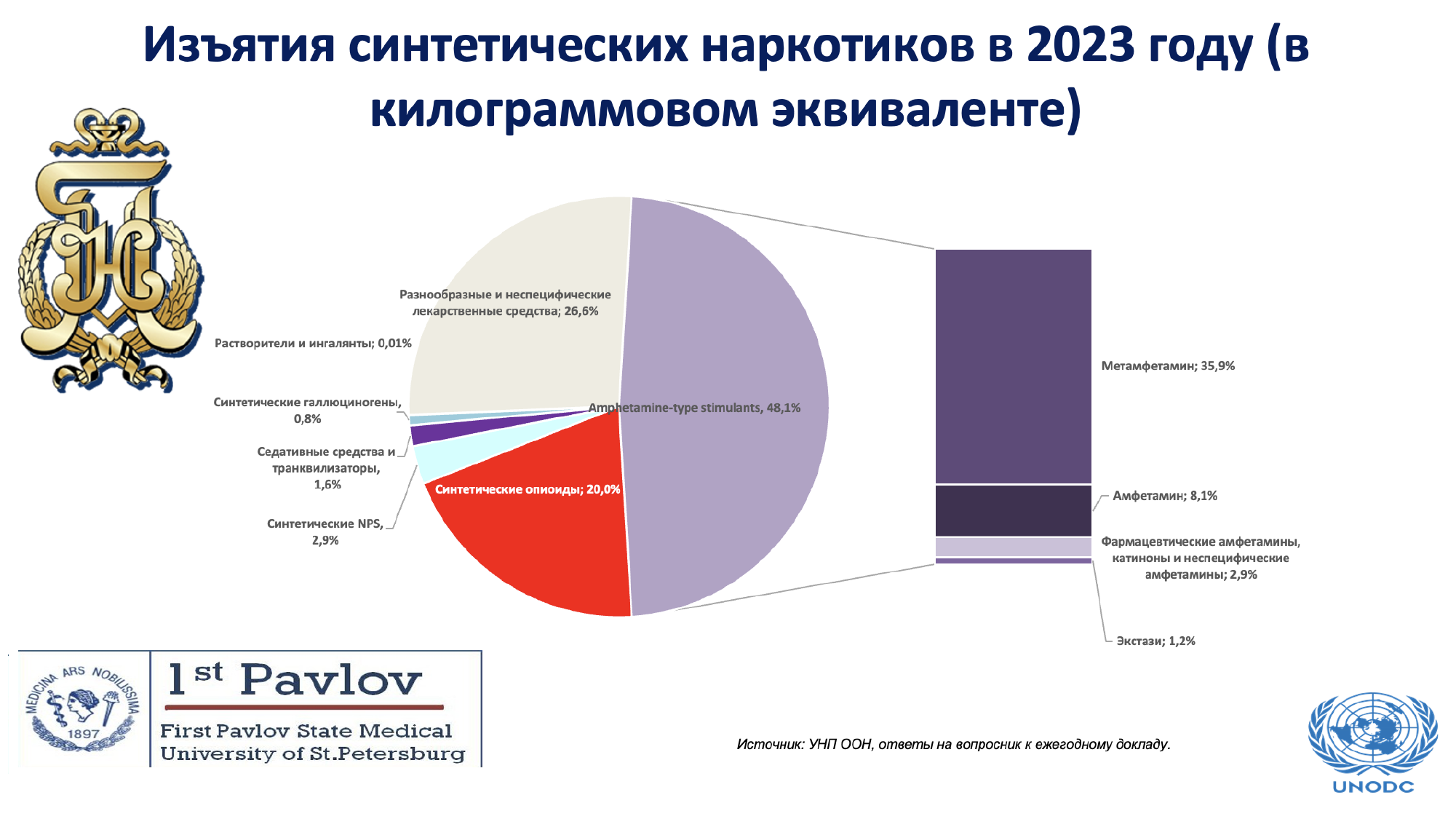
What is the value shown for Экстази? 1,2% What is the difference in percentage points between Amphetamine-type stimulants and Разнообразные и неспецифические лекарственные средства? 21,5% Which category has the largest share of the pie? Amphetamine-type stimulants How many categories are shown in the main pie chart? 7 Which is larger: Синтетические NPS or Седативные средства и транквилизаторы? Синтетические NPS Which category has the smallest share of the pie? Растворители и ингалянты What is the difference in percentage points between Метамфетамин and Амфетамин in the breakout bar? 27,8% What is the value shown for Синтетические опиоиды? 20,0% What is the value shown for Метамфетамин in the breakout bar? 35,9% What share of the pie does Amphetamine-type stimulants account for? 48,1% How many segments are shown in the breakout bar for Amphetamine-type stimulants? 4 What kind of chart is shown on the slide? Pie chart